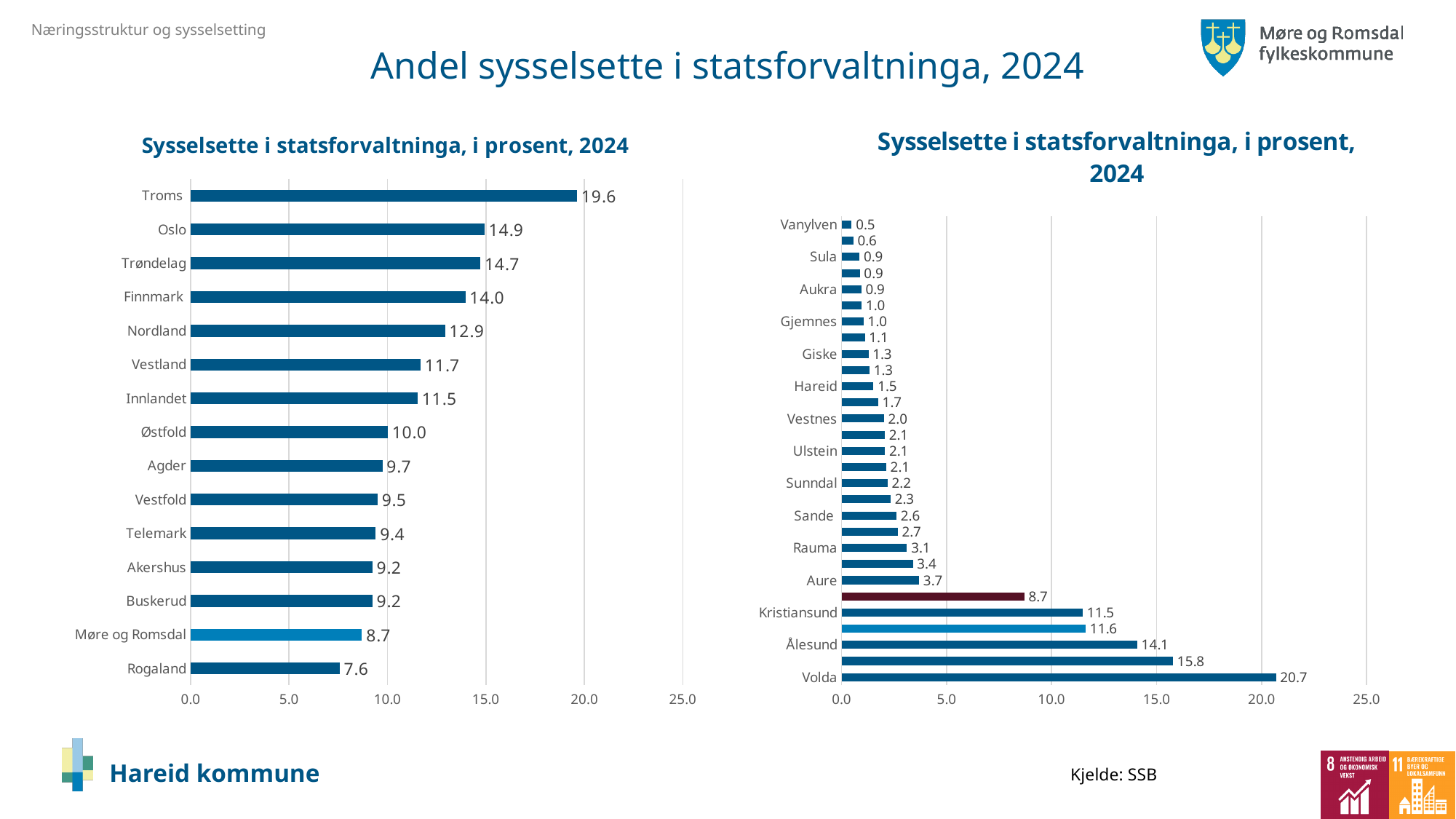
In the right chart, what is the value for Volda? 20.7 What kind of chart is the left chart? Bar chart In the left chart, which category has the highest value? Troms In the right chart, which category has the highest value? Volda In the left chart, what is the difference between the values for Oslo and Rogaland? 7.3 In the left chart, what is the value for Troms? 19.6 In the right chart, what is the value for Hareid? 1.5 In the left chart, which category has the lowest value? Rogaland In the right chart, which has the larger value, Rauma or Sande? Rauma In the left chart, what is the value for Møre og Romsdal? 8.7 In the right chart, what is the difference between the values for Ålesund and Kristiansund? 2.6 How many categories are shown in the left chart? 15